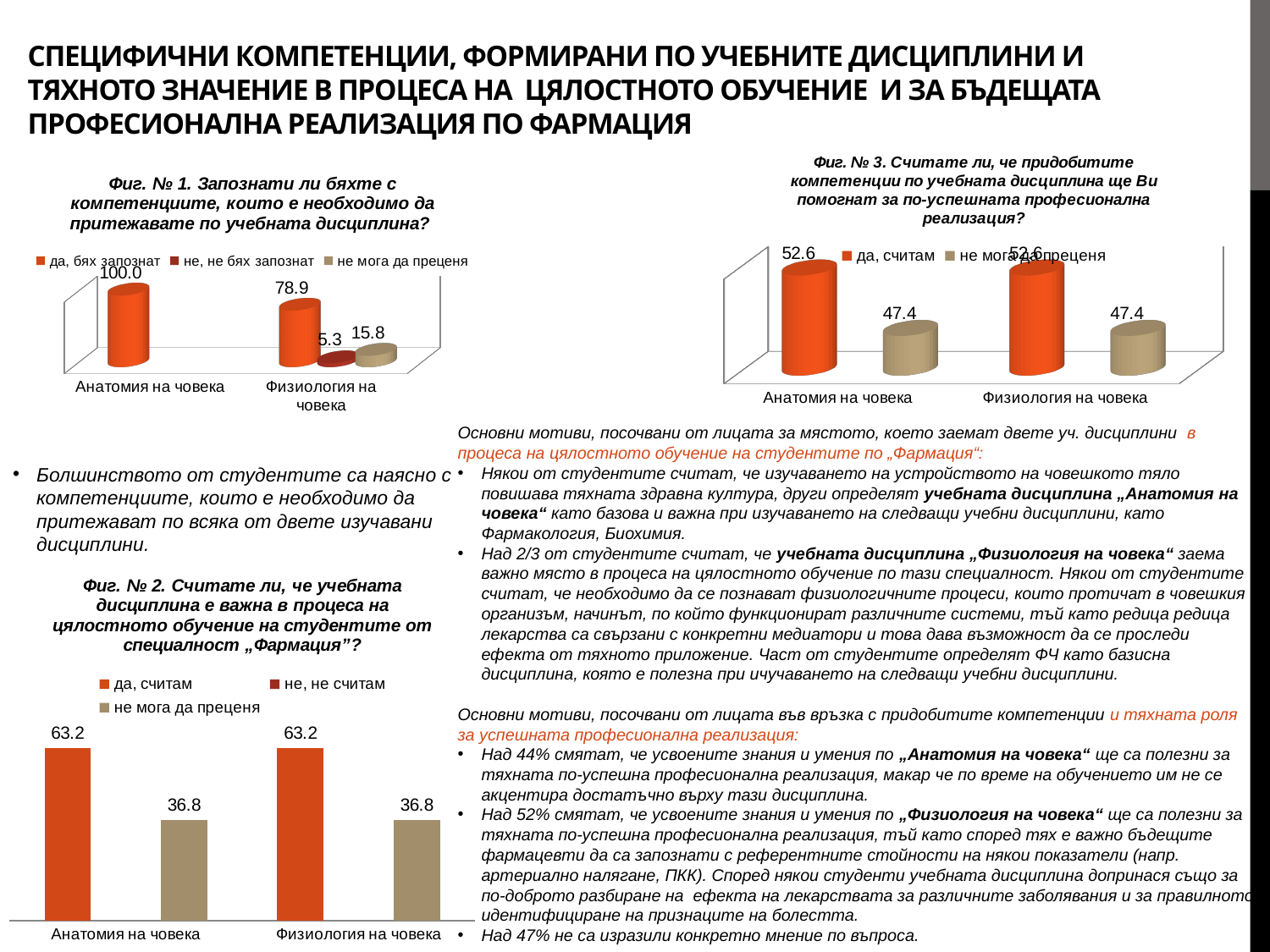
In Фиг. № 3, what is the difference between "да, считам" and "не мога да преценя" for Анатомия на човека? 5.2 In Фиг. № 1, what is the value for "да, бях запознат" for Анатомия на човека? 100.0 In Фиг. № 3, how many categories are shown on the x axis? 2 In Фиг. № 1, what is the difference between the "да, бях запознат" values for Анатомия на човека and Физиология на човека? 21.1 In Фиг. № 1, how many series does the legend list? 3 In Фиг. № 2, what is the value for "не мога да преценя" for Анатомия на човека? 36.8 In Фиг. № 1, what is the value for "не, не бях запознат" for Физиология на човека? 5.3 In Фиг. № 2, which is larger for Анатомия на човека: "да, считам" or "не мога да преценя"? да, считам In Фиг. № 2, what kind of chart is shown? Bar chart In Фиг. № 2, what is the value for "да, считам" for Физиология на човека? 63.2 In Фиг. № 3, what is the value for "не мога да преценя" for Физиология на човека? 47.4 In Фиг. № 1, what is the value for "не мога да преценя" for Физиология на човека? 15.8